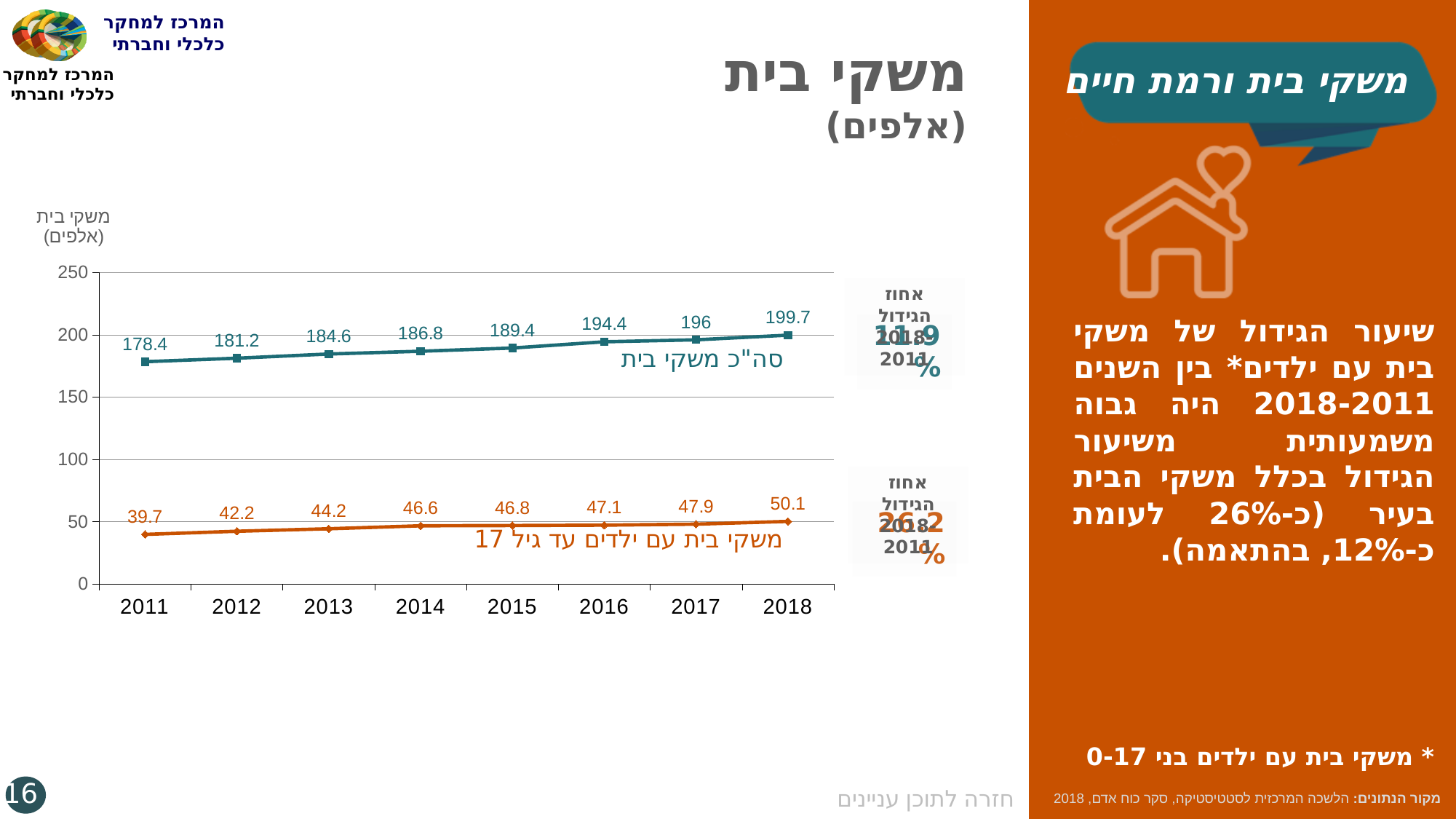
What is the difference between the סה"כ משקי בית values in 2018 and 2011? 21.3 What is the value for סה"כ משקי בית in 2016? 194.4 How many series are plotted in the chart? 2 In which year is the value for סה"כ משקי בית highest? 2018 Does the value for סה"כ משקי בית rise or fall from 2011 to 2018? rise How many years are plotted on the x axis? 8 Which is larger: the value for משקי בית עם ילדים עד גיל 17 in 2017 or in 2012? 2017 What is the value for משקי בית עם ילדים עד גיל 17 in 2014? 46.6 What is the value for סה"כ משקי בית in 2011? 178.4 In which year is the value for משקי בית עם ילדים עד גיל 17 lowest? 2011 What is the value for משקי בית עם ילדים עד גיל 17 in 2018? 50.1 What type of chart is shown on the slide? line chart